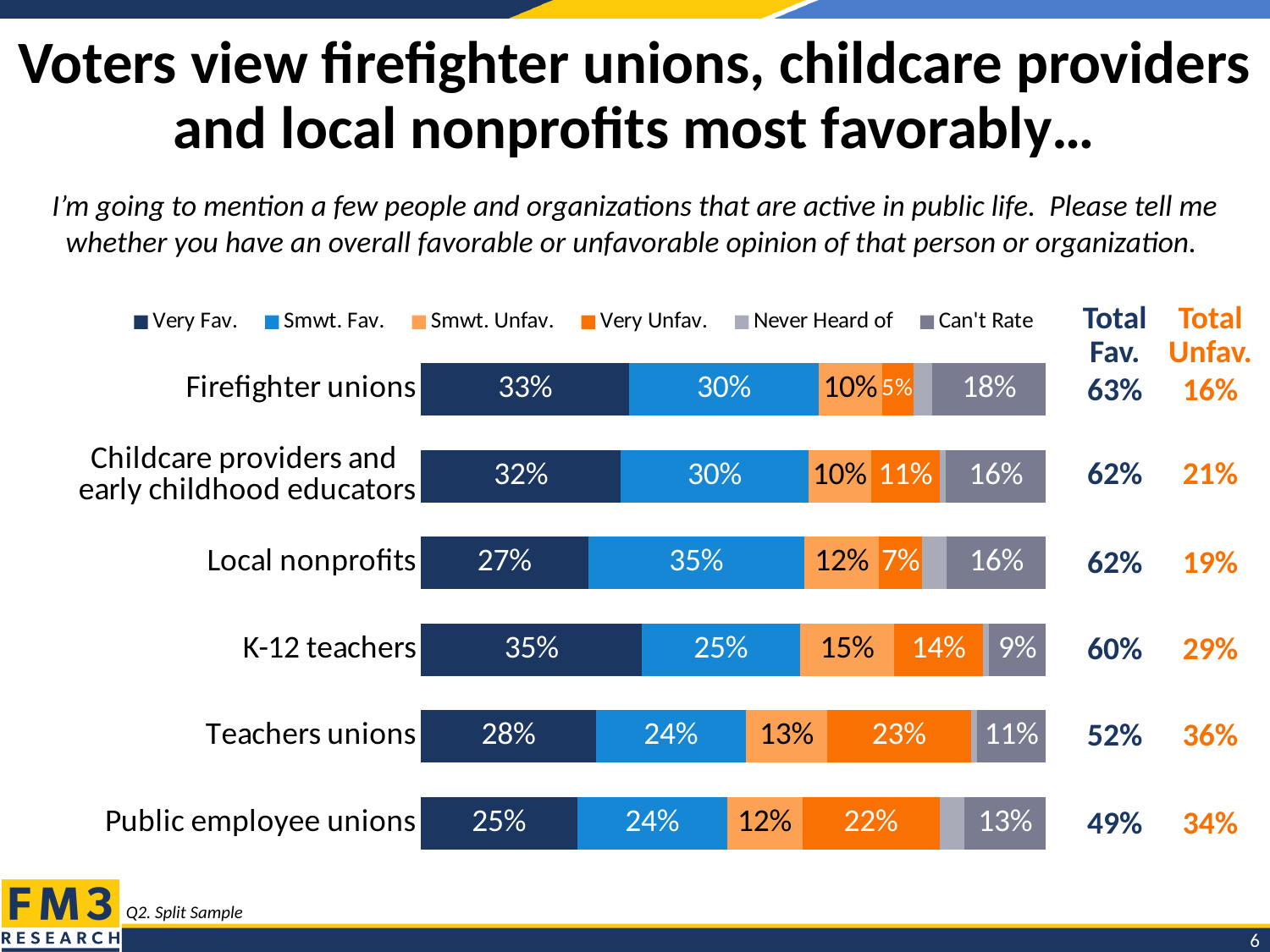
What is the difference between the Very Fav. value for K-12 teachers and the Very Fav. value for Public employee unions? 10 percentage points Which category has the highest Very Fav. value? K-12 teachers What is the Very Fav. value for Firefighter unions? 33% Which category has the highest Total Unfav. value? Teachers unions How many series does the legend list? 6 What kind of chart is shown on the slide? Stacked bar chart Which category has the lowest Total Fav. value? Public employee unions How many categories (organizations) are shown in the chart? 6 What is the Total Unfav. value shown for K-12 teachers? 29% What is the Very Unfav. value for Teachers unions? 23% Which has a larger Smwt. Unfav. value, K-12 teachers or Teachers unions? K-12 teachers What is the Smwt. Fav. value for Local nonprofits? 35%